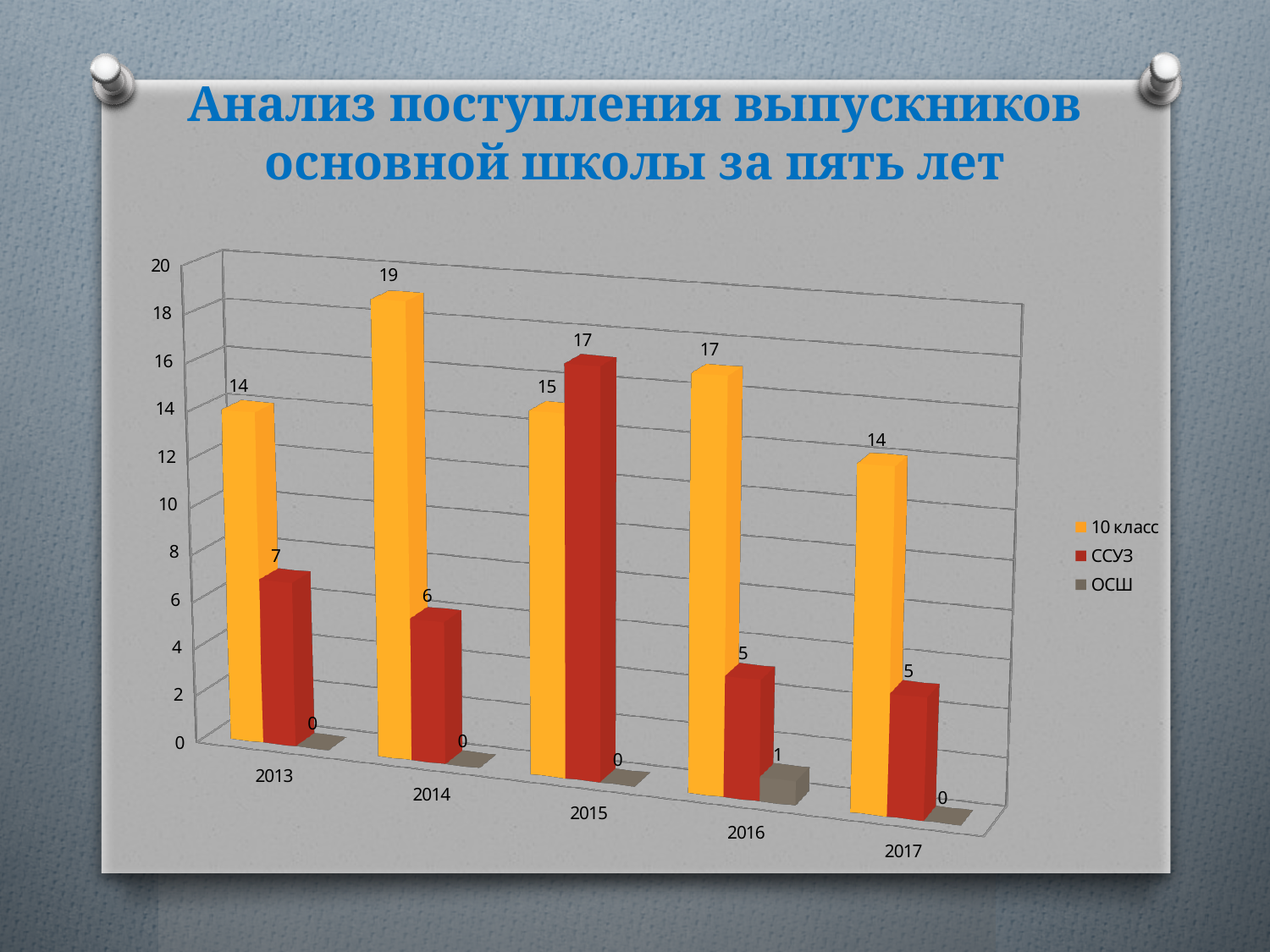
What colour are the bars for the 10 класс series? yellow/orange How many years are shown on the x axis? 5 In which year is the value for 10 класс highest? 2014 Which is larger in 2015, the value for 10 класс or for ССУЗ? ССУЗ What is the difference between the 10 класс and ССУЗ values in 2013? 7 What is the value for ОСШ in 2016? 1 Does the value for ССУЗ rise or fall from 2015 to 2017? fall What is the value for ССУЗ in 2015? 17 How many series does the legend list? 3 In which year is the value for ССУЗ lowest? 2016 and 2017 What is the value for 10 класс in 2014? 19 What kind of chart is shown on the slide? bar chart